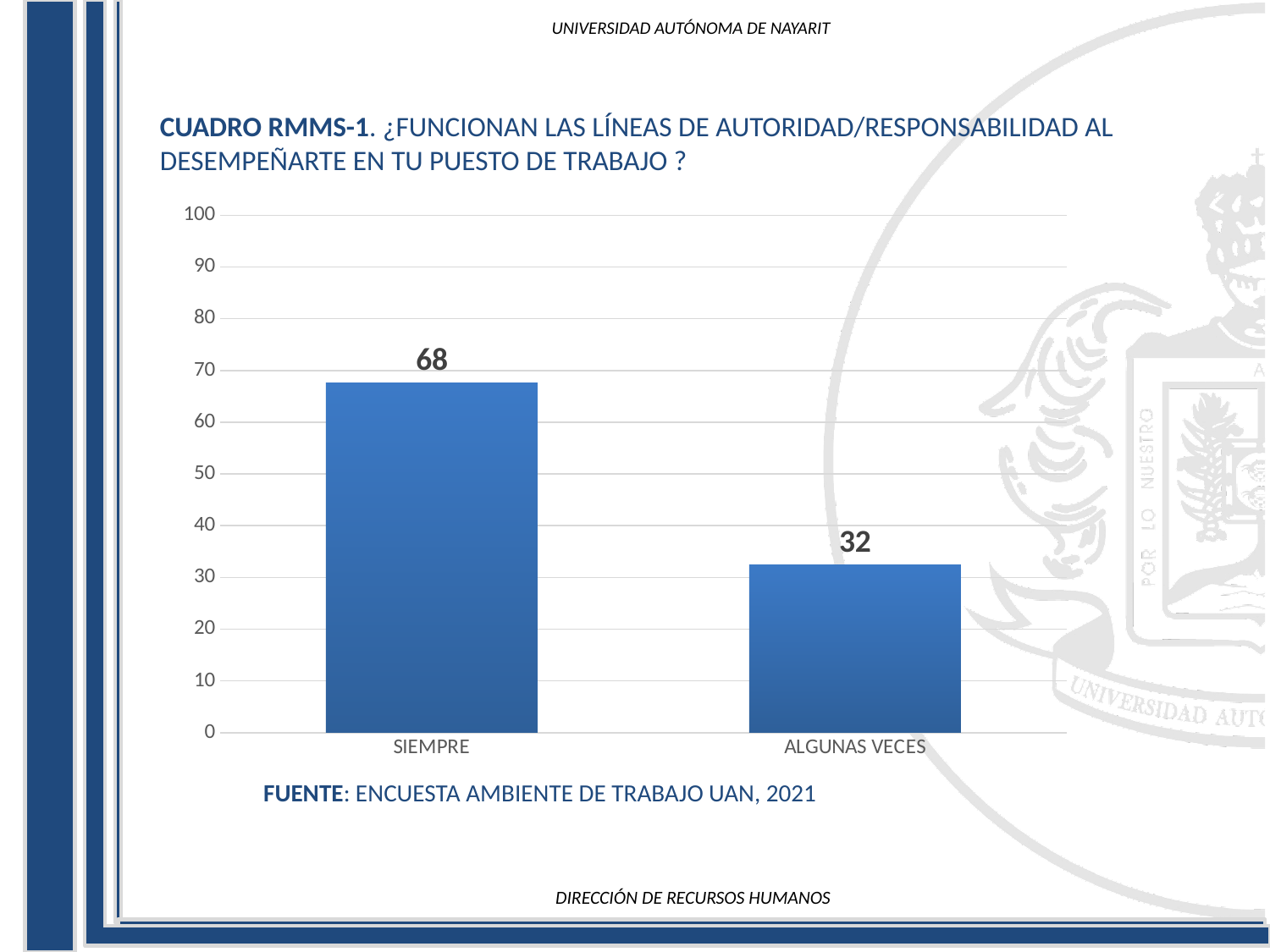
Which is larger, the value for SIEMPRE or the value for ALGUNAS VECES? SIEMPRE What is the source cited below the chart? ENCUESTA AMBIENTE DE TRABAJO UAN, 2021 Which category has the highest value? SIEMPRE What is the value for SIEMPRE? 68 How many categories are shown on the x axis? 2 Is the value for SIEMPRE greater or less than 60? greater What is the total of the two values shown in the chart? 100 Is the value for ALGUNAS VECES greater or less than 40? less What is the difference between the values for SIEMPRE and ALGUNAS VECES? 36 Which category has the lowest value? ALGUNAS VECES What kind of chart is shown on the slide? bar chart What is the value for ALGUNAS VECES? 32